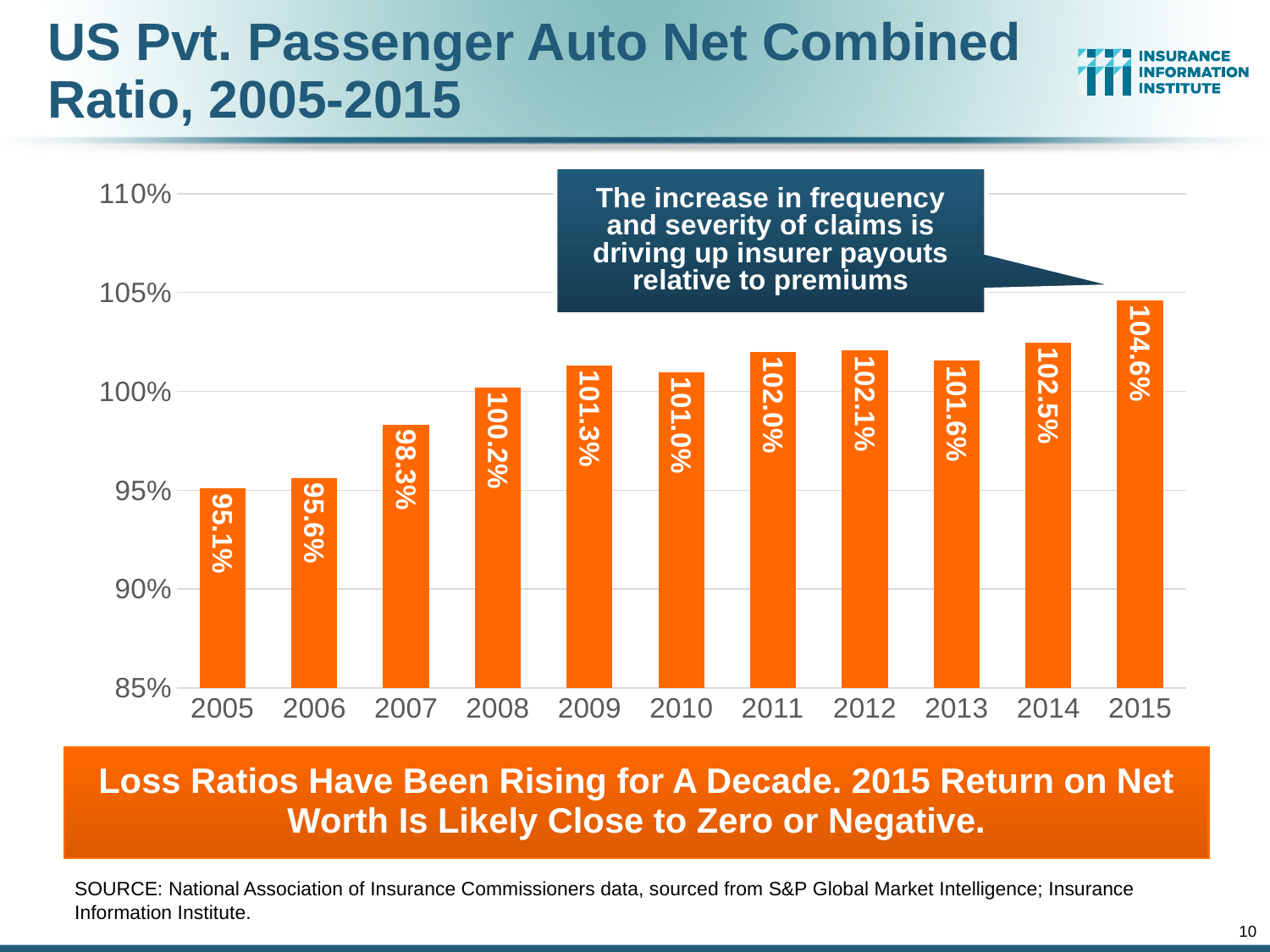
What kind of chart is shown on the slide? Bar chart Which year has the highest net combined ratio? 2015 How many years are shown on the chart? 11 What is the difference between the 2015 and 2005 net combined ratios? 9.5 percentage points Do the net combined ratio values generally rise or fall from 2005 to 2015? Rise What is the net combined ratio for 2010? 101.0% Which year has a higher net combined ratio, 2012 or 2013? 2012 What is the difference between the 2014 and 2013 net combined ratios? 0.9 percentage points Is the value for 2008 greater or less than 100%? greater What is the net combined ratio for 2007? 98.3% Which year has the lowest net combined ratio? 2005 What is the net combined ratio for 2015? 104.6%